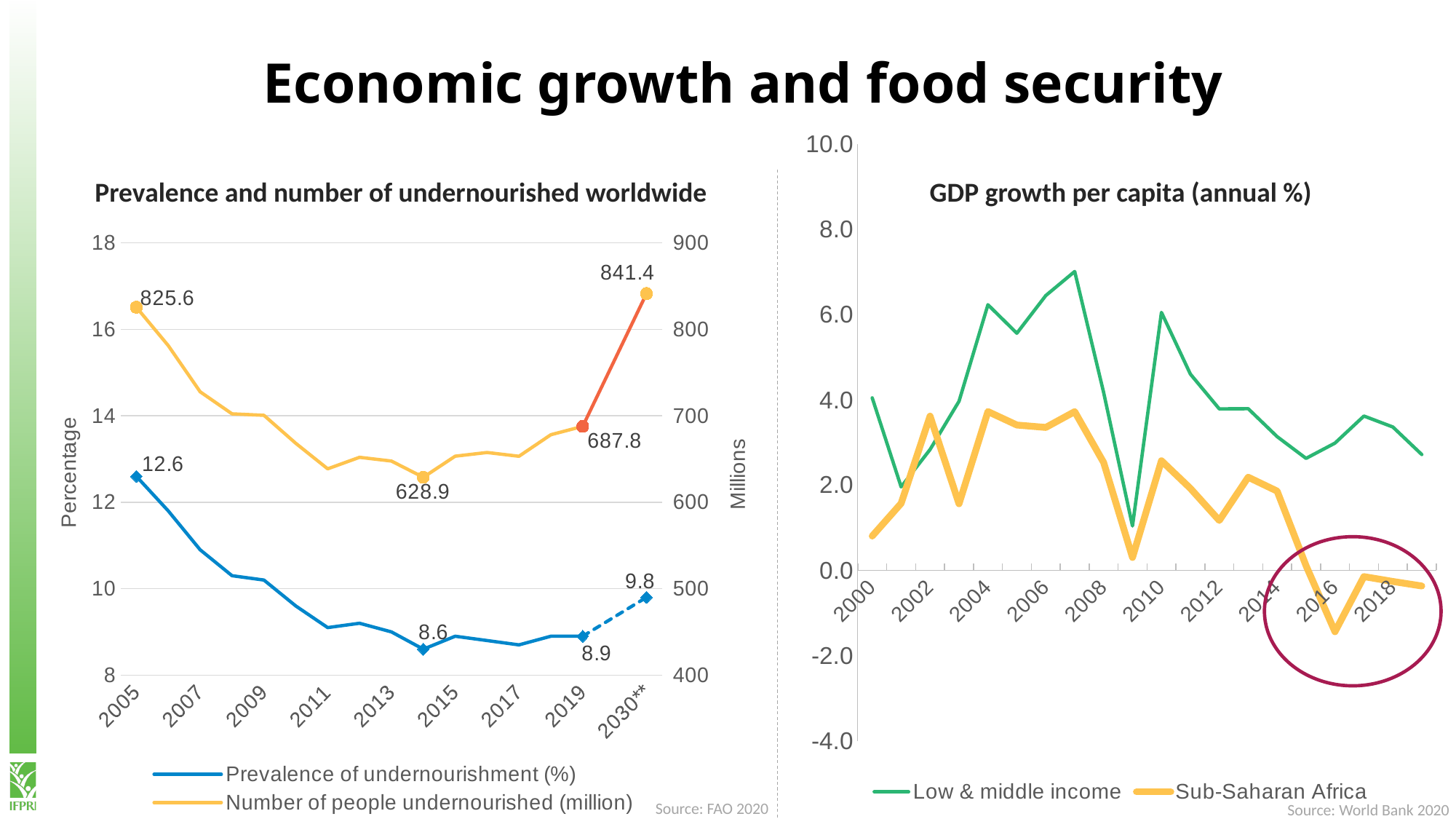
How many series does the legend of the 'Prevalence and number of undernourished worldwide' chart list? 2 In the 'GDP growth per capita (annual %)' chart, is the value for Sub-Saharan Africa in 2016 greater or less than 0.0? less In the 'Prevalence and number of undernourished worldwide' chart, what is the projected number of people undernourished (million) for 2030**? 841.4 In the 'Prevalence and number of undernourished worldwide' chart, in which year is the number of people undernourished at its lowest labelled value? 2014 In the 'GDP growth per capita (annual %)' chart, is the value for Low & middle income in 2007 greater or less than 6.0? greater In the 'Prevalence and number of undernourished worldwide' chart, what is the prevalence of undernourishment (%) in 2019? 8.9 In the 'Prevalence and number of undernourished worldwide' chart, what is the difference between the number of people undernourished in 2030** and in 2019? 153.6 What kind of chart is the 'Prevalence and number of undernourished worldwide' chart? Line chart How many series does the legend of the 'GDP growth per capita (annual %)' chart list? 2 In the 'Prevalence and number of undernourished worldwide' chart, by how many percentage points did the prevalence of undernourishment fall from 2005 to 2014? 4.0 In the 'GDP growth per capita (annual %)' chart, which series has the higher value in 2007: Low & middle income or Sub-Saharan Africa? Low & middle income In the 'Prevalence and number of undernourished worldwide' chart, what is the number of people undernourished (million) in 2005? 825.6